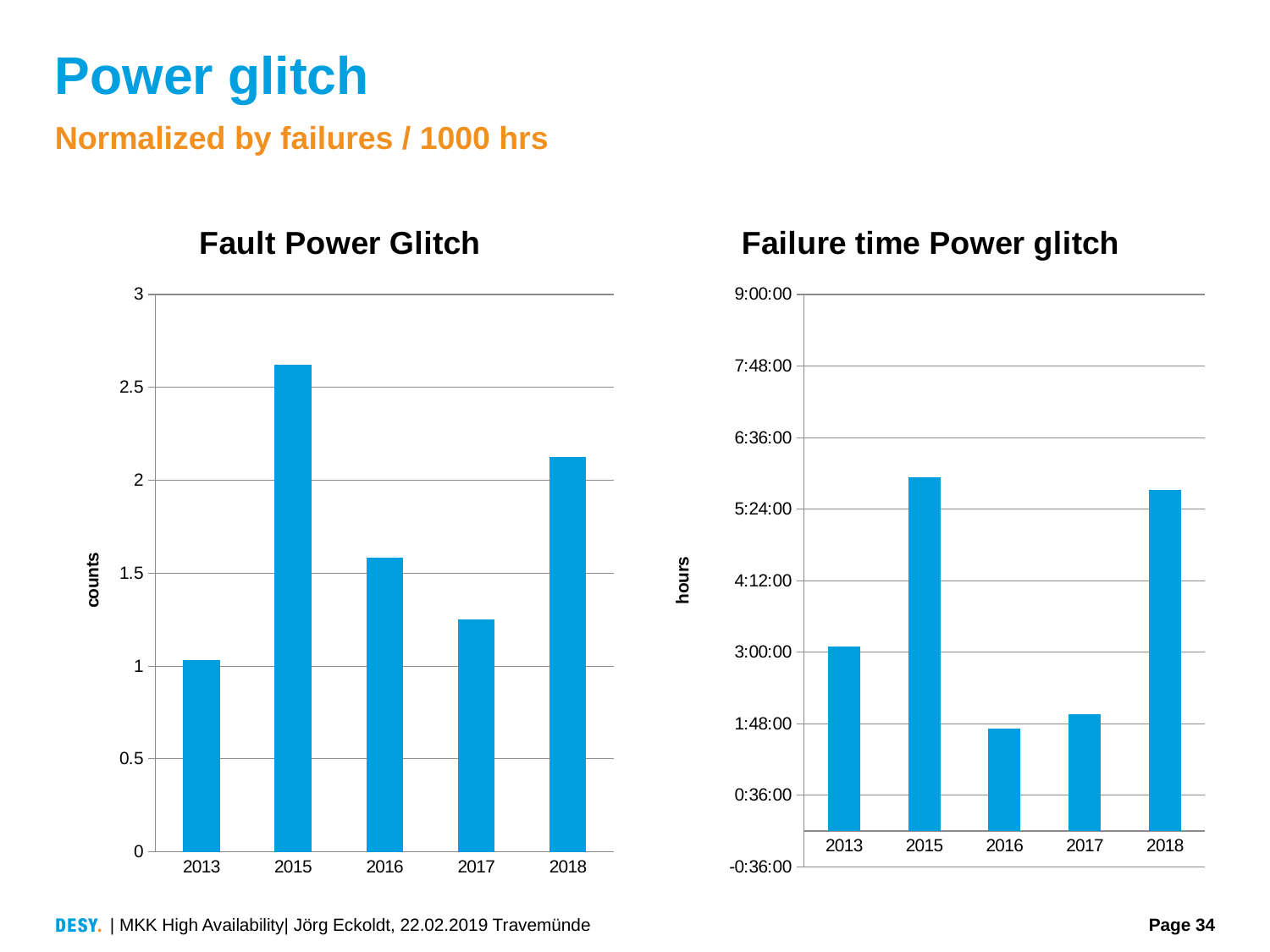
In the 'Fault Power Glitch' chart, which year has the highest value? 2015 In the 'Fault Power Glitch' chart, is the value for 2015 greater or less than 2.5? greater What is the y-axis label of the 'Failure time Power glitch' chart? hours In the 'Failure time Power glitch' chart, is the value for 2016 greater or less than 3:00:00? less In the 'Fault Power Glitch' chart, which is larger, the value for 2016 or the value for 2018? 2018 What is the y-axis label of the 'Fault Power Glitch' chart? counts In the 'Failure time Power glitch' chart, which is larger, the value for 2015 or the value for 2017? 2015 In the 'Fault Power Glitch' chart, which year has the lowest value? 2013 What type of chart is the 'Fault Power Glitch' chart? bar chart How many years are shown on the x axis of the 'Fault Power Glitch' chart? 5 In the 'Failure time Power glitch' chart, is the value for 2013 greater or less than 1:48:00? greater